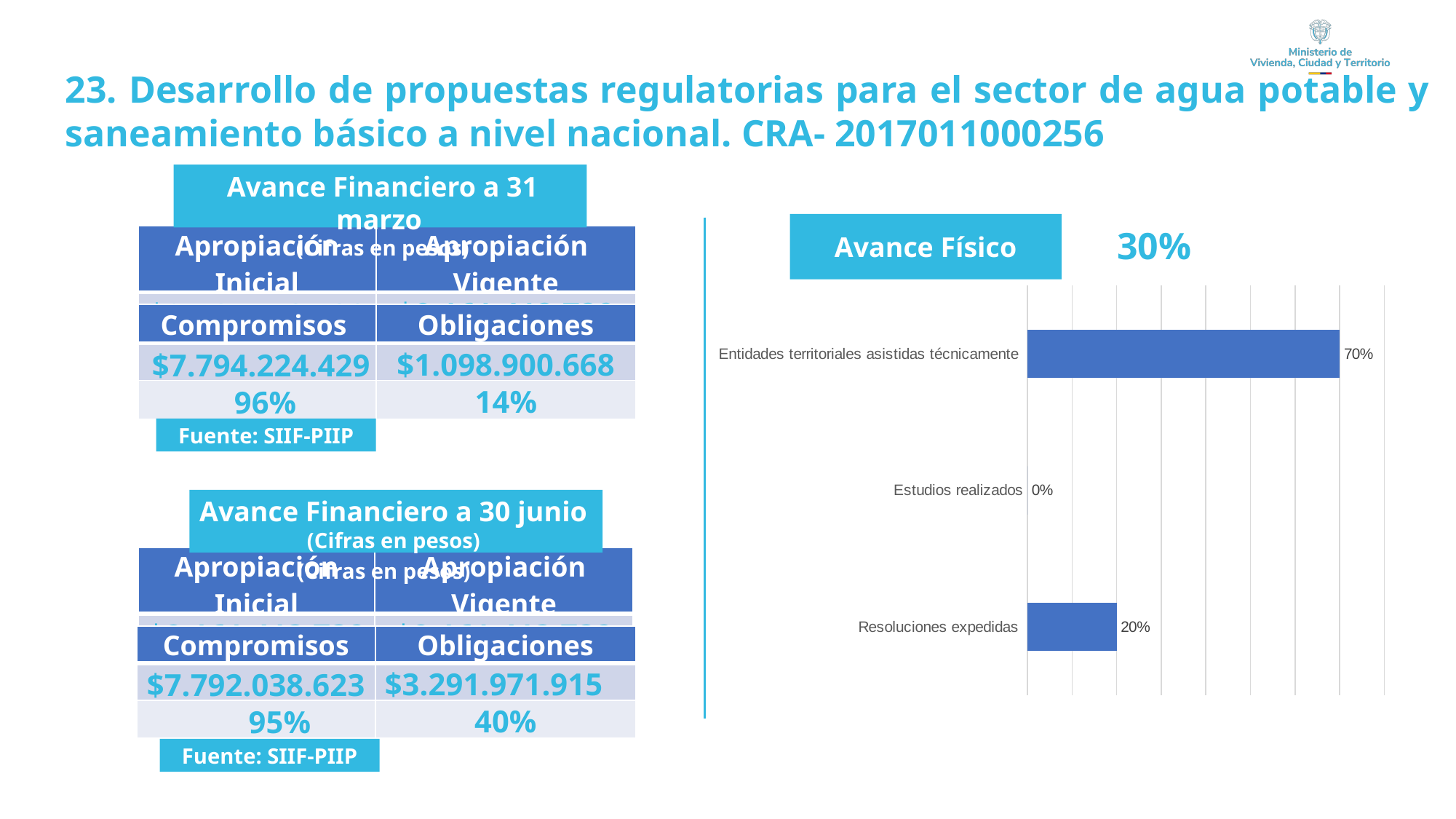
What is the value for Estudios realizados in the Avance Físico chart? 0% What overall percentage is shown next to the Avance Físico chart title? 30% Which category has the highest value in the Avance Físico chart? Entidades territoriales asistidas técnicamente Which category has the lowest value in the Avance Físico chart? Estudios realizados What is the title of the chart on the right side of the slide? Avance Físico What is the value for Resoluciones expedidas in the Avance Físico chart? 20% How many categories are shown in the Avance Físico chart? 3 What is the difference between the values for Entidades territoriales asistidas técnicamente and Resoluciones expedidas in the Avance Físico chart? 50% In the Avance Físico chart, which is larger: Resoluciones expedidas or Estudios realizados? Resoluciones expedidas What is the value for Entidades territoriales asistidas técnicamente in the Avance Físico chart? 70% What kind of chart is the Avance Físico chart? Bar chart